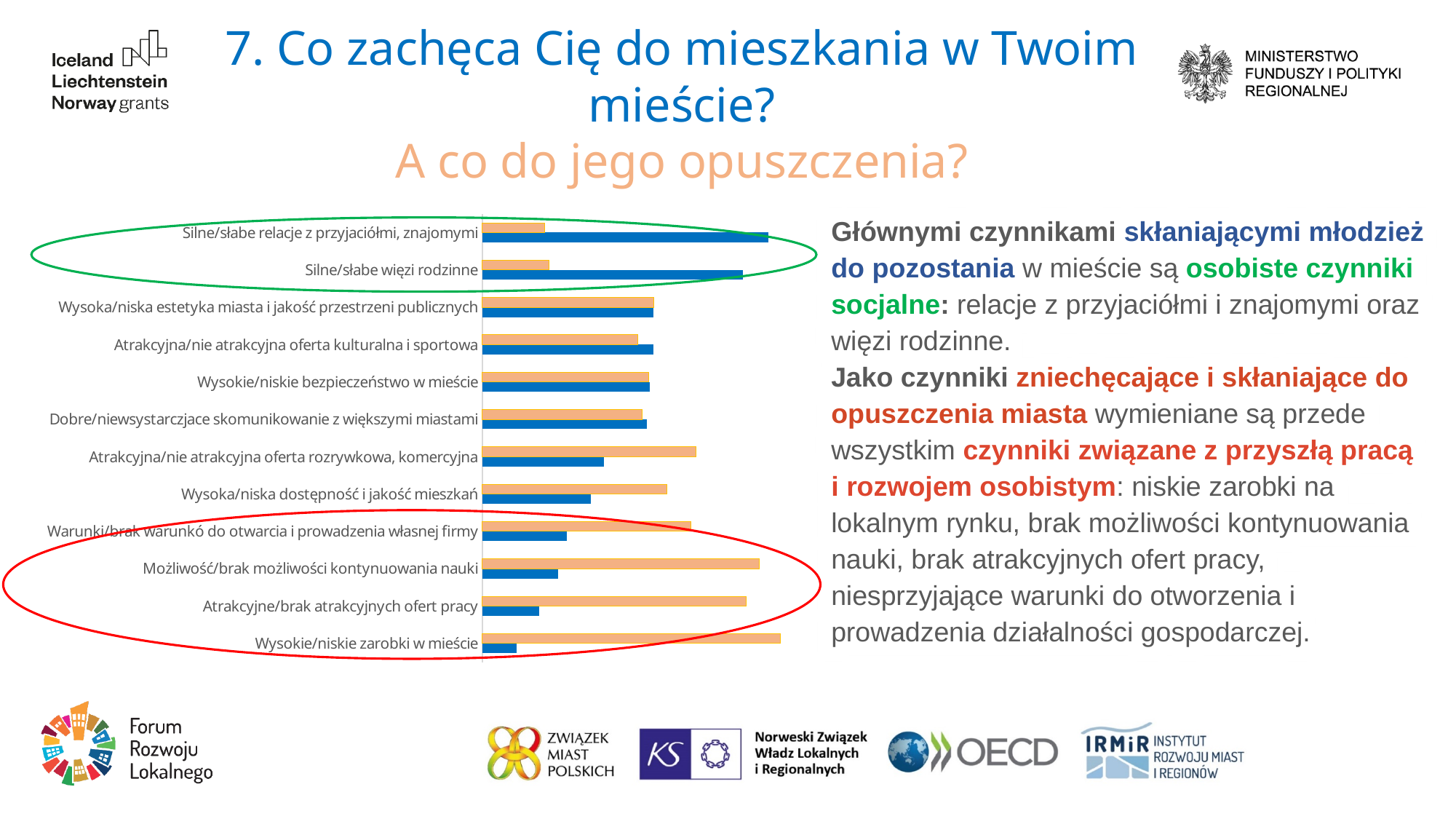
For "Atrakcyjna/nie atrakcyjna oferta rozrywkowa, komercyjna", which bar is longer, the blue one or the orange one? orange What two colours are used for the bars in the chart? blue and orange Which category has the longest blue bar? Silne/słabe relacje z przyjaciółmi, znajomymi Which two categories on the chart are circled in green? Silne/słabe relacje z przyjaciółmi, znajomymi and Silne/słabe więzi rodzinne How many categories are listed on the chart's vertical axis? 12 How many bars are plotted for each category on the chart? 2 Which category has the shortest blue bar? Wysokie/niskie zarobki w mieście For "Wysokie/niskie zarobki w mieście", which bar is longer, the blue one or the orange one? orange Which has the longer orange bar: "Możliwość/brak możliwości kontynuowania nauki" or "Silne/słabe więzi rodzinne"? Możliwość/brak możliwości kontynuowania nauki What kind of chart is shown on the slide? bar chart